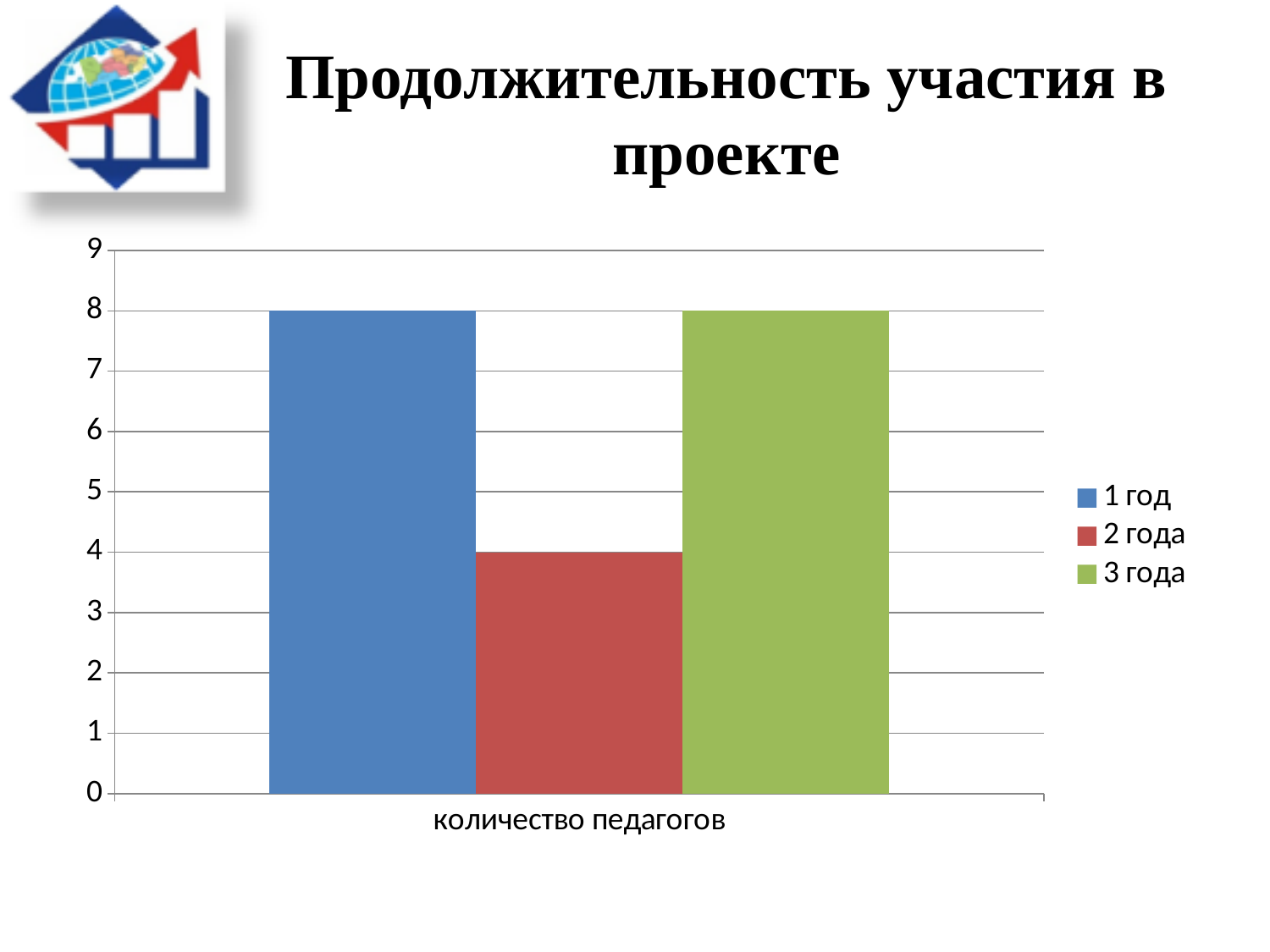
Is the value for "1 год" greater or less than 5? greater What is the difference between the values for "1 год" and "2 года"? 4 What kind of chart is shown on the slide? bar chart How many series does the legend list? 3 What is the value for the "3 года" series in the chart? 8 What is the label on the x axis of the chart? количество педагогов Is the value for "2 года" greater or less than 6? less What is the value for the "1 год" series in the chart? 8 What is the value for the "2 года" series in the chart? 4 Which is larger, the value for "3 года" or the value for "2 года"? 3 года What is the title of the slide's chart? Продолжительность участия в проекте Which series has the lowest value in the chart? 2 года